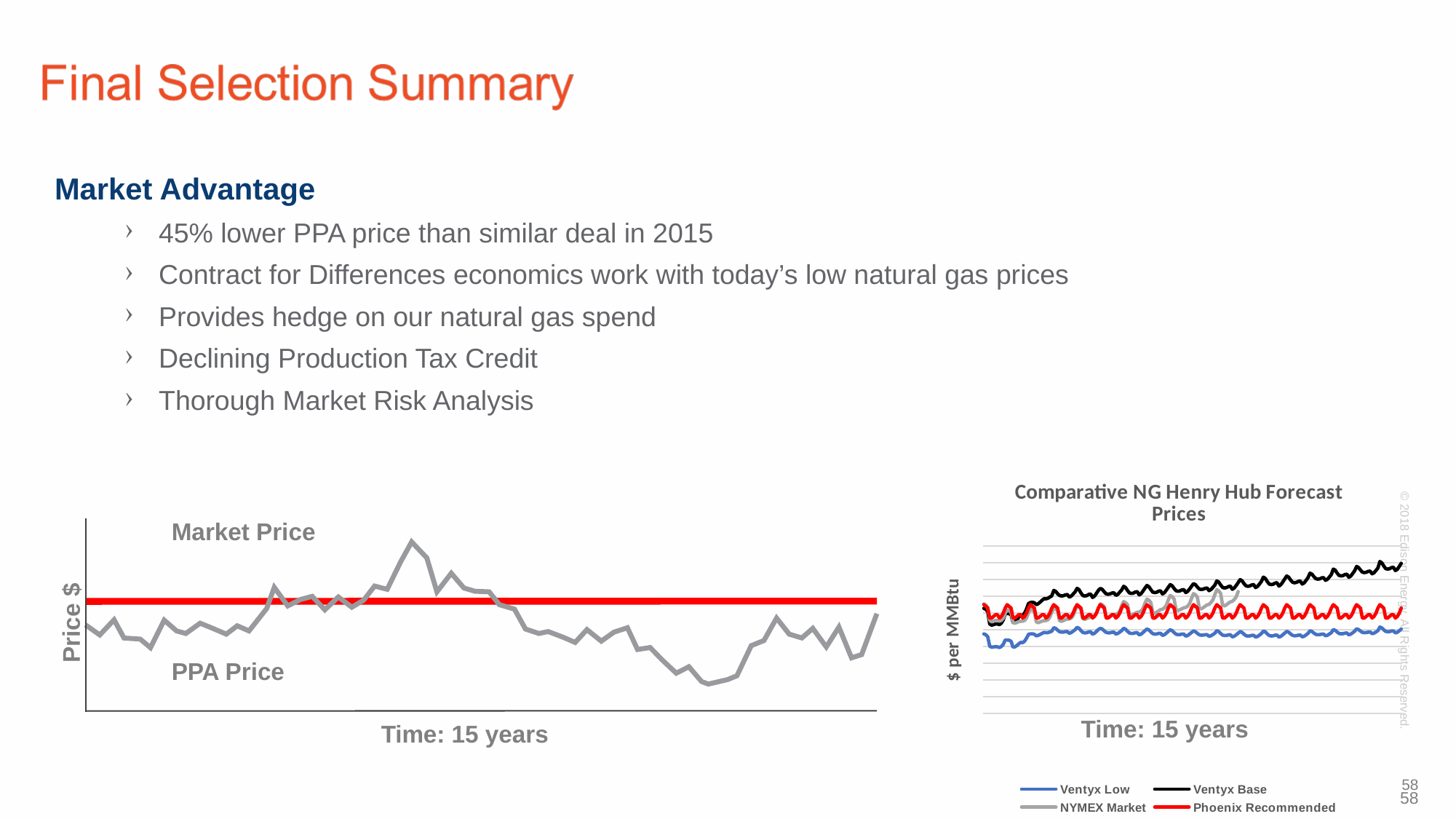
In the "Comparative NG Henry Hub Forecast Prices" chart, which series is the lowest across the time period? Ventyx Low In the "Comparative NG Henry Hub Forecast Prices" chart, which series is the highest at the end of the time period? Ventyx Base What time span is shown on the x-axis of the left chart showing Market Price and PPA Price? Time: 15 years What is the y-axis label of the "Comparative NG Henry Hub Forecast Prices" chart? $ per MMBtu In the left chart, which line is drawn as a flat horizontal red line, Market Price or PPA Price? PPA Price What kind of chart is the chart titled "Comparative NG Henry Hub Forecast Prices"? line chart In the "Comparative NG Henry Hub Forecast Prices" chart, which is higher at the end of the period, Ventyx Base or Ventyx Low? Ventyx Base How many series does the legend of the "Comparative NG Henry Hub Forecast Prices" chart list? 4 In the "Comparative NG Henry Hub Forecast Prices" chart, does the Ventyx Base series rise or fall over time? rise What kind of chart is the left chart showing Market Price and PPA Price? line chart